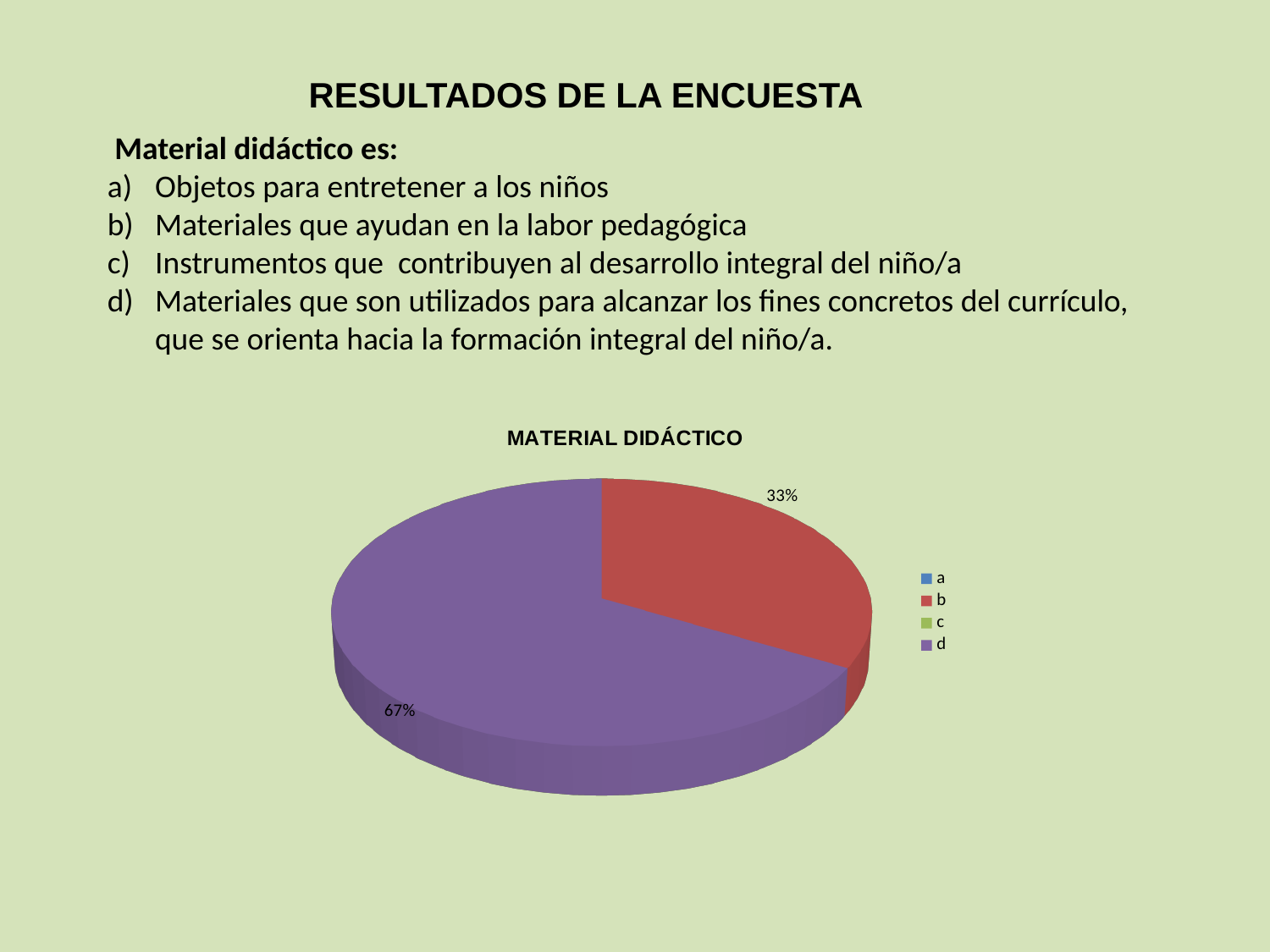
Which is larger, the share for b or the share for d? d What percentage of the pie does category b represent? 33% What kind of chart is shown on the slide? pie chart What is the difference between the share for d and the share for b? 34% What percentage of the pie does category d represent? 67% What colour is the slice for category d? purple Which category has the largest share of the pie? d How many entries does the legend list? 4 How many slices are visible in the pie? 2 What is the title of the chart? MATERIAL DIDÁCTICO